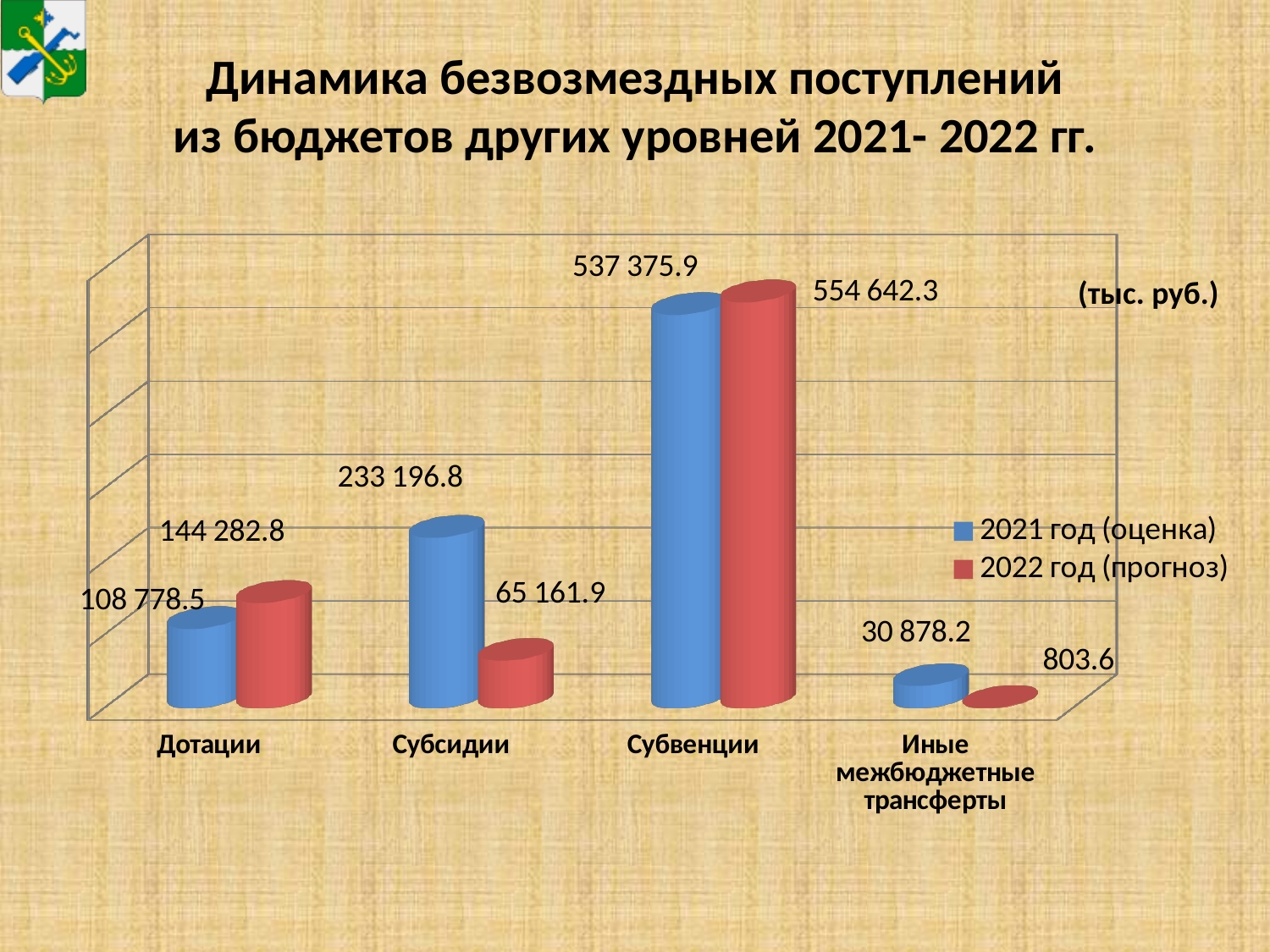
What is the difference between the 2022 год (прогноз) and 2021 год (оценка) values for Дотации? 35 504.3 What is the value for Дотации in the 2021 год (оценка) series? 108 778.5 What is the difference between the 2021 год (оценка) and 2022 год (прогноз) values for Субсидии? 168 034.9 For Субвенции, which series has the larger value: 2021 год (оценка) or 2022 год (прогноз)? 2022 год (прогноз) What unit is indicated for the values on the chart? тыс. руб. Which category has the lowest value in the 2022 год (прогноз) series? Иные межбюджетные трансферты How many categories are shown on the x axis? 4 What is the value for Иные межбюджетные трансферты in the 2022 год (прогноз) series? 803.6 How many series does the legend list? 2 Which category has the highest value in the 2021 год (оценка) series? Субвенции What kind of chart is shown on the slide? Bar chart What is the value for Субсидии in the 2022 год (прогноз) series? 65 161.9